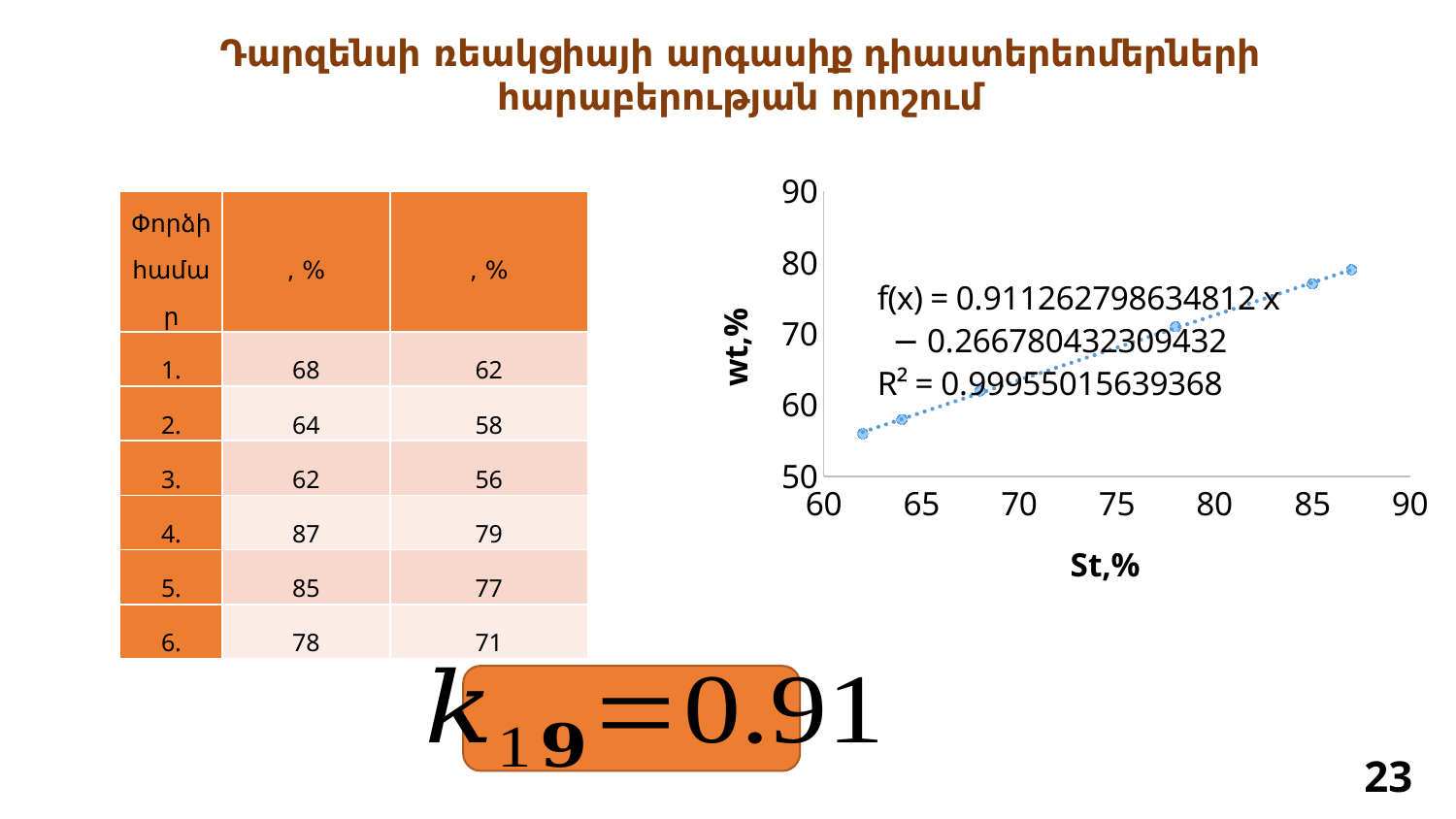
Is the wt,% value of the point at St,% = 78 greater or less than 60? greater Is the wt,% value of the rightmost plotted point greater or less than 70? greater Which plotted point has the highest wt,% value, the one at the far left or the one at the far right of the chart? the one at the far right Do the plotted wt,% values rise or fall as St,% increases along the x axis? rise What is the title of the x axis of the chart? St,% Is the wt,% value of the point at St,% = 68 greater or less than 70? less What is the R² value printed on the chart? 0.99955015639368 What kind of chart is shown on the slide? scatter chart How many data points are plotted on the chart? 6